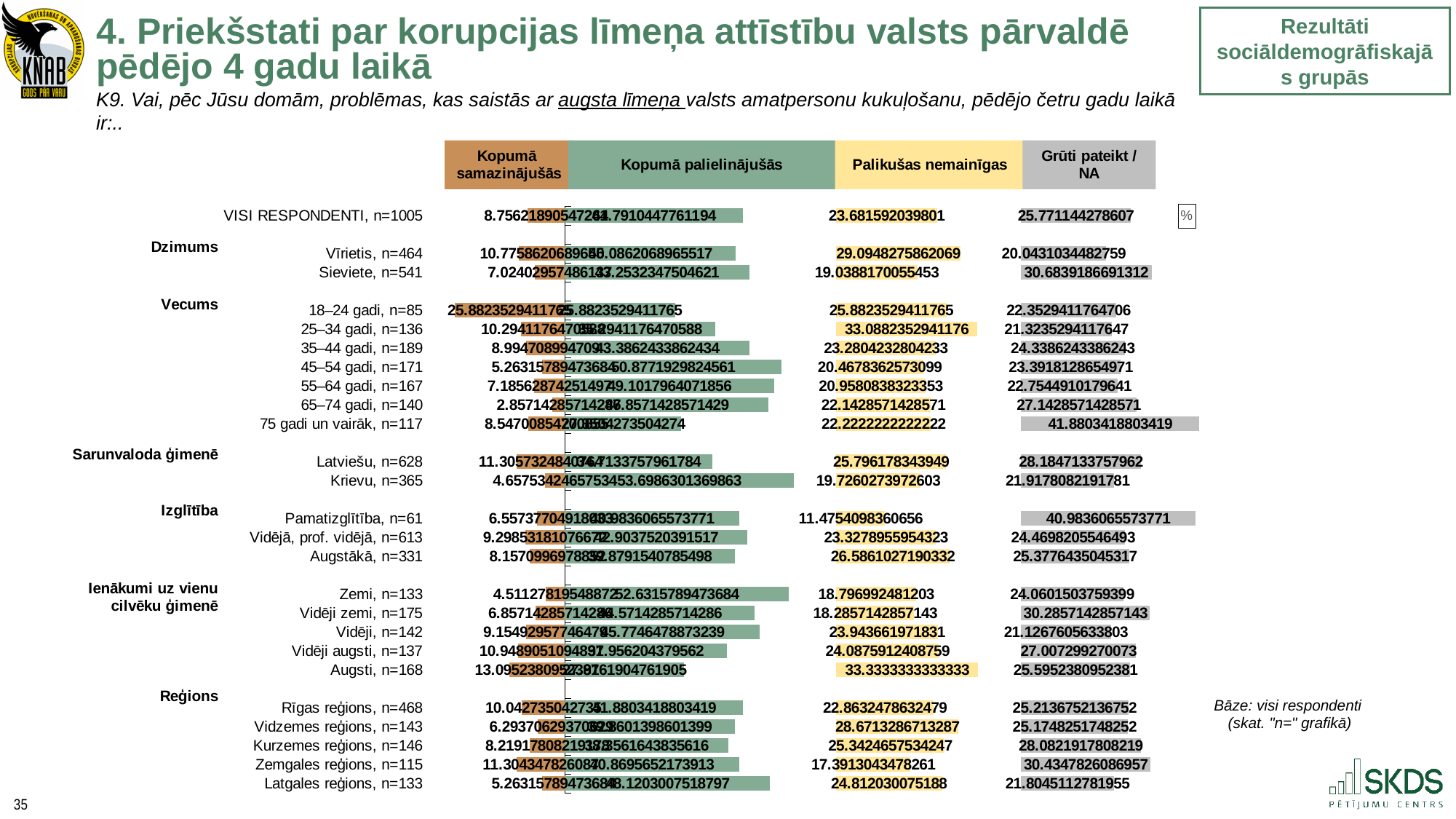
What is the value of "Palikušas nemainīgas" for Augsti, n=168? 33.3333333333333 How many series does the legend list? 4 What is the difference between the "Grūti pateikt / NA" values for Sieviete, n=541 and Vīrietis, n=464? 10.6408152208553 Which category has the highest value for "Grūti pateikt / NA"? 75 gadi un vairāk, n=117 What is the value of "Grūti pateikt / NA" for 75 gadi un vairāk, n=117? 41.8803418803419 What kind of chart is shown on the slide? bar chart What colour represents the "Kopumā palielinājušās" series in the legend? green What is the value of "Palikušas nemainīgas" for Vīrietis, n=464? 29.0948275862069 What is the value of "Grūti pateikt / NA" for VISI RESPONDENTI, n=1005? 25.771144278607 For "Grūti pateikt / NA", which is larger: Vīrietis, n=464 or Sieviete, n=541? Sieviete, n=541 Which category has the lowest value for "Palikušas nemainīgas"? Pamatizglītība, n=61 What is the value of "Grūti pateikt / NA" for Pamatizglītība, n=61? 40.9836065573771